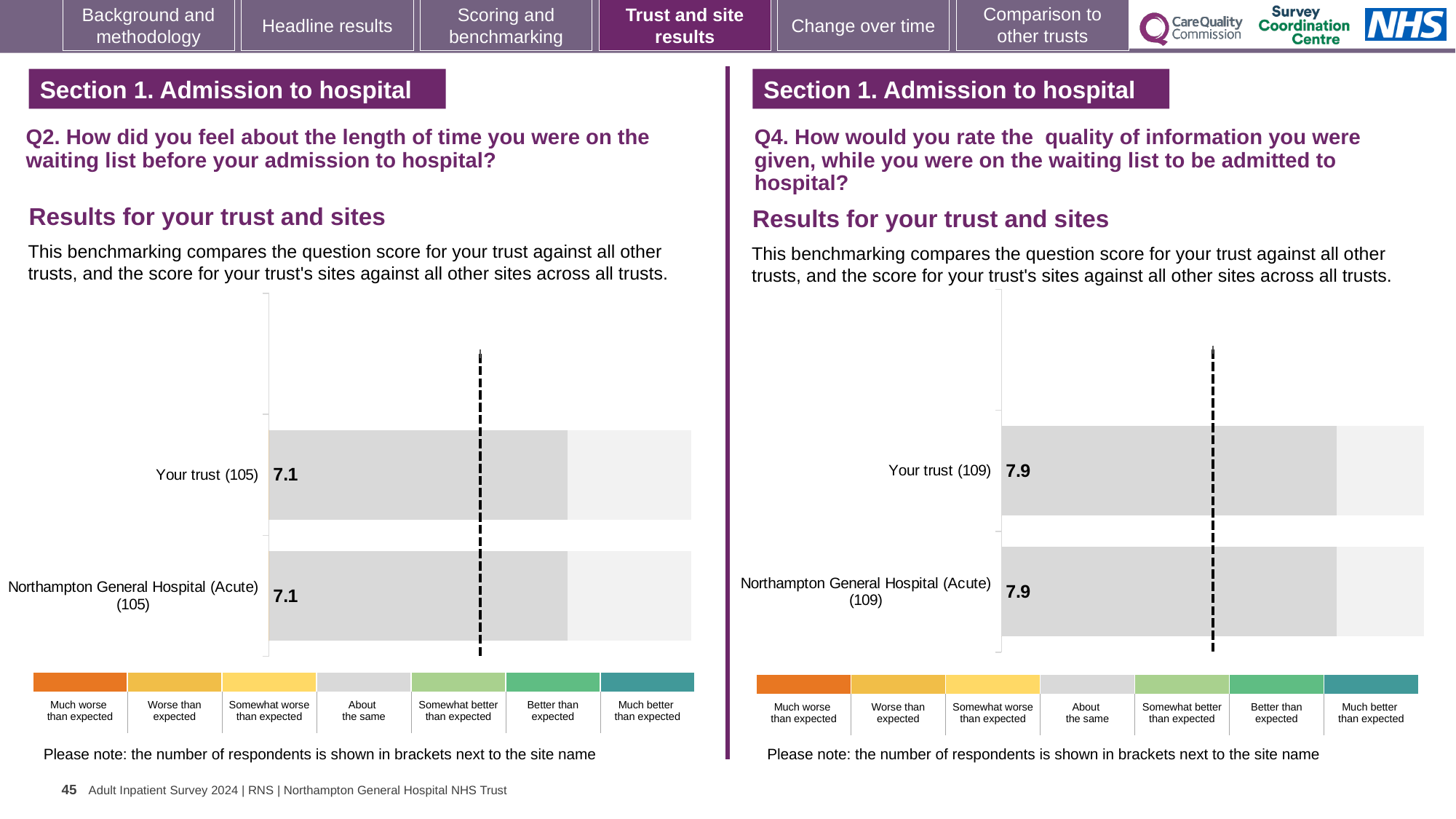
On the right chart (Q4), what is the score for Your trust? 7.9 Is the score for Your trust on the right chart (Q4) larger or smaller than the score for Your trust on the left chart (Q2)? Larger On the right chart (Q4), what is the score for Northampton General Hospital (Acute)? 7.9 How many bars are plotted on the left chart (Q2)? 2 On the right chart (Q4), how many respondents are shown in brackets for Northampton General Hospital (Acute)? 109 What kind of chart is used on the left (Q2)? Bar chart On the left chart (Q2), what is the score for Your trust? 7.1 On the left chart (Q2), how many respondents are shown in brackets for Your trust? 105 On the left chart (Q2), what is the score for Northampton General Hospital (Acute)? 7.1 How many bars are plotted on the right chart (Q4)? 2 On the left chart (Q2), what is the difference between the score for Your trust and the score for Northampton General Hospital (Acute)? 0 On the right chart (Q4), what is the difference between the score for Your trust and the score for Northampton General Hospital (Acute)? 0